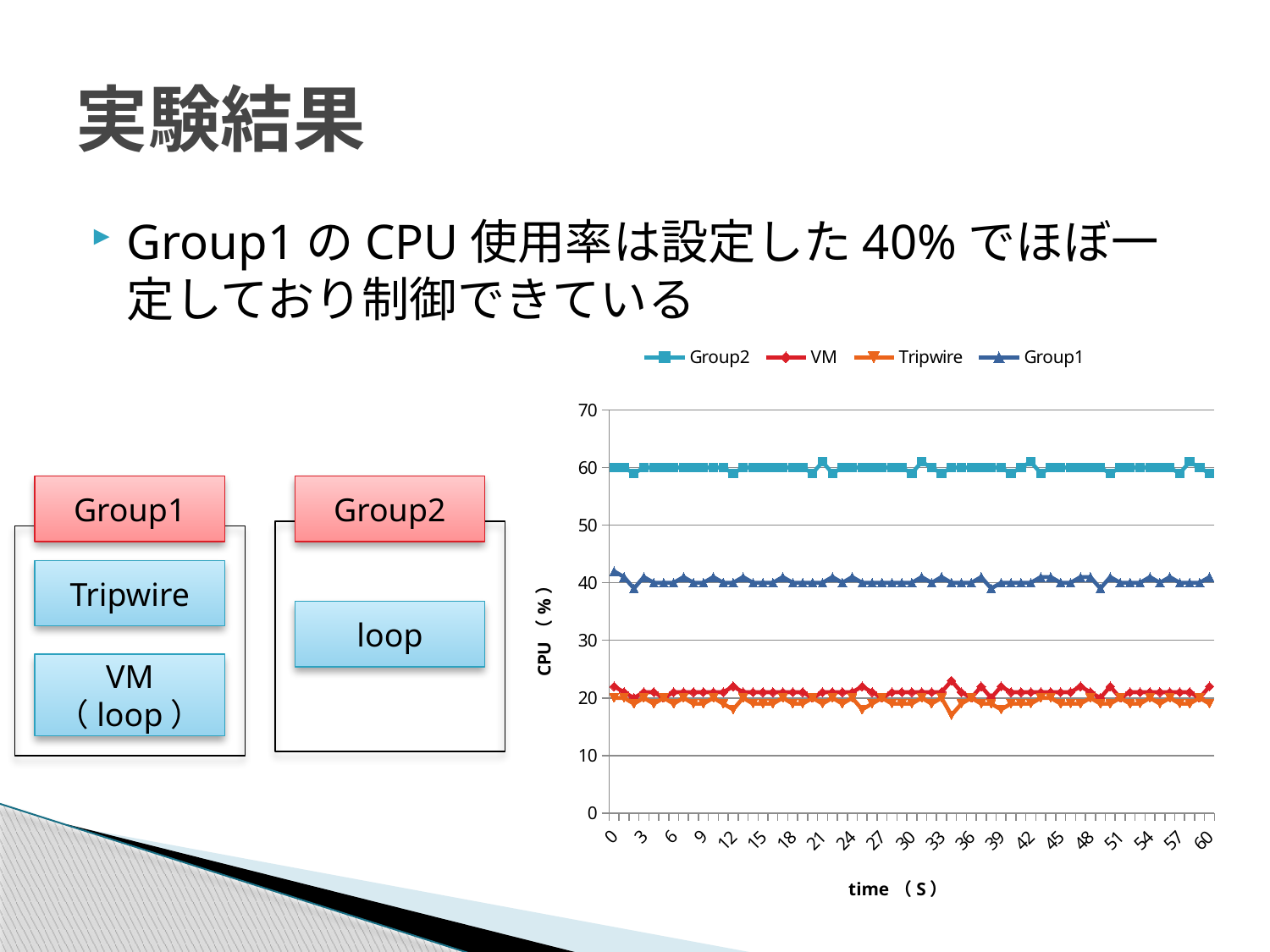
Which series has higher CPU usage, Group2 or Group1? Group2 What is the label of the vertical axis? CPU (%) Is the CPU value for Group1 greater or less than 30? greater Is the CPU value for Group2 greater or less than 50? greater How many series does the chart legend list? 4 Is the CPU value for Tripwire greater or less than 30? less Which series has the highest CPU usage throughout the chart? Group2 What is the label of the horizontal axis? time (S) What kind of chart is shown on the slide? line chart Does the Group1 line rise, fall, or stay roughly constant over time? stays roughly constant Which series has higher CPU usage, Group1 or VM? Group1